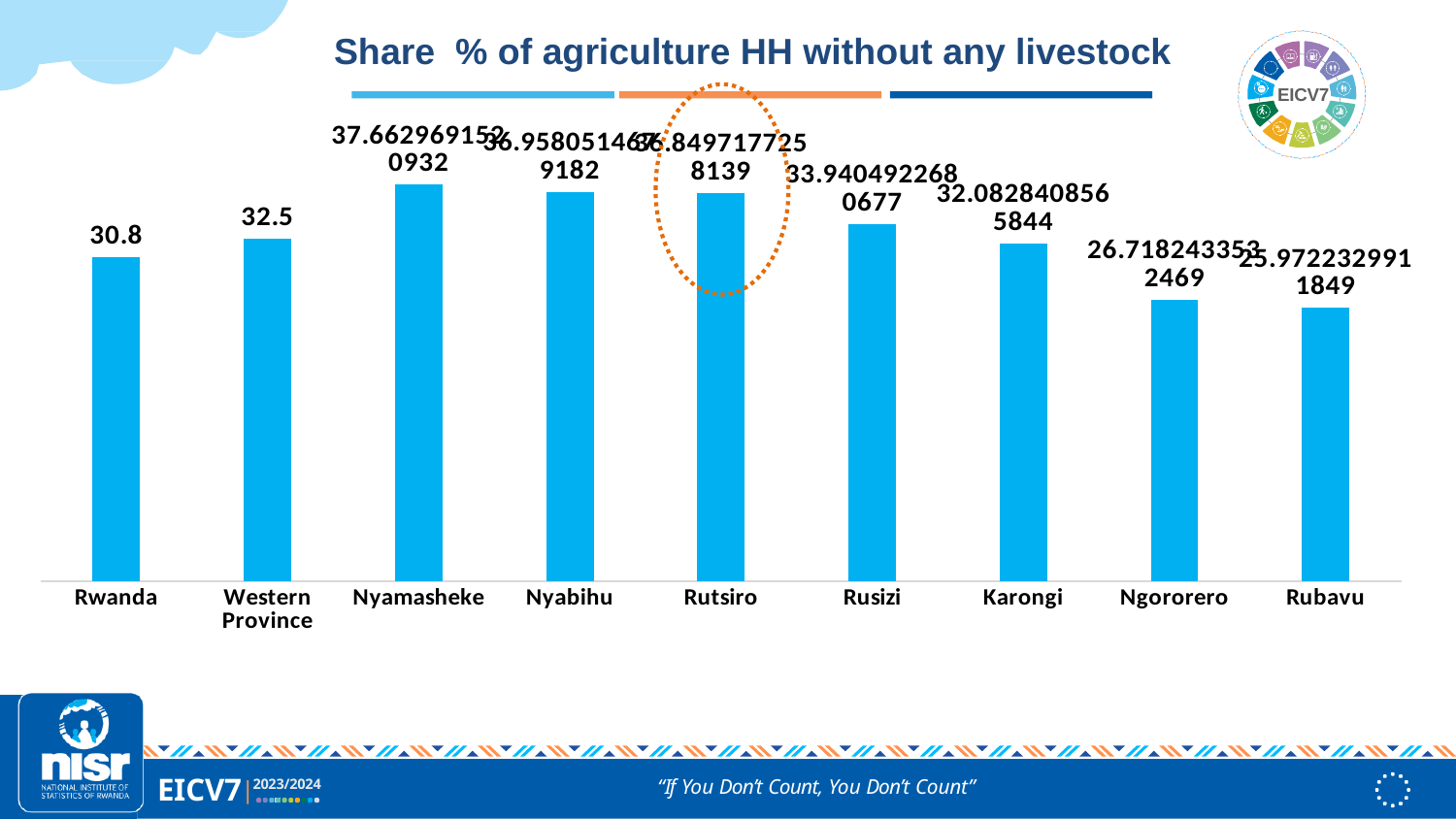
Which category has the highest value? Nyamasheke Which category has the lowest value? Rubavu Which category's bar is highlighted with a dotted orange circle? Rutsiro Which is larger, the value for Rusizi or the value for Karongi? Rusizi Which is larger, the value for Rwanda or the value for Western Province? Western Province What is the value for Rwanda? 30.8 How many categories are shown on the x axis? 9 What type of chart is shown on the slide? bar chart Do the values rise or fall from Rutsiro to Rubavu along the x axis? fall What is the value for Western Province? 32.5 What is the title of the chart? Share % of agriculture HH without any livestock What is the difference between the values for Western Province and Rwanda? 1.7